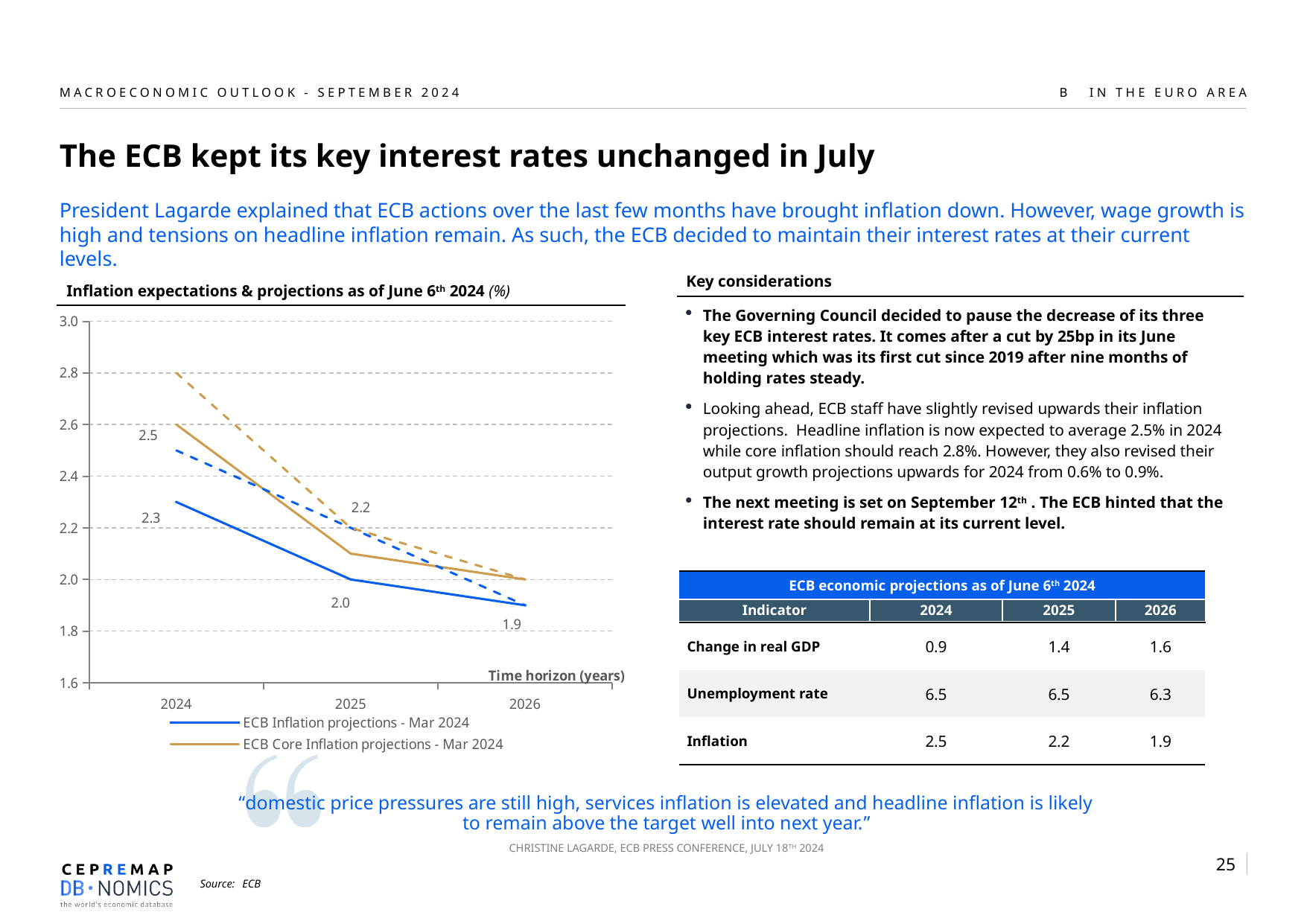
What kind of chart is shown on the slide? Line chart What is the value of ECB Inflation projections - Mar 2024 for 2024? 2.3 What is the title of the x axis of the chart? Time horizon (years) What is the difference between the ECB Inflation projections - Mar 2024 values for 2024 and 2025? 0.3 Is the value for ECB Core Inflation projections - Mar 2024 in 2024 greater or less than 2.4? greater In 2024, which is higher: ECB Core Inflation projections - Mar 2024 or ECB Inflation projections - Mar 2024? ECB Core Inflation projections - Mar 2024 In which year is the ECB Inflation projections - Mar 2024 series at its highest? 2024 Do the plotted lines rise or fall from 2024 to 2026? Fall How many series does the chart legend list? 2 How many years are shown on the x axis of the chart? 3 Is the value for ECB Core Inflation projections - Mar 2024 in 2025 greater or less than 2.4? less What is the value of ECB Inflation projections - Mar 2024 for 2025? 2.0